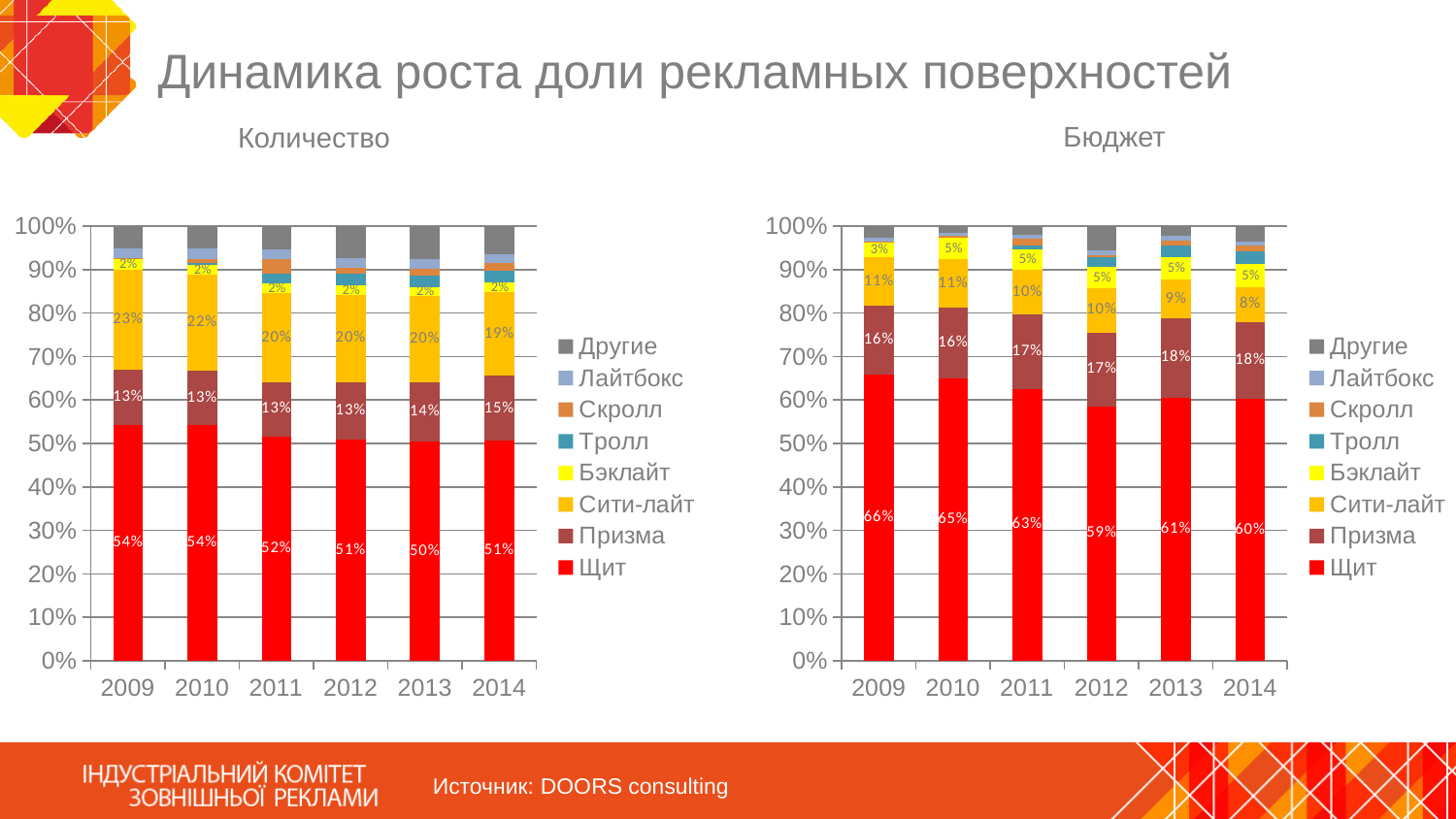
How many series does the legend of the Бюджет chart list? 8 In the Бюджет chart, what is the value for Призма in 2014? 18% In the Бюджет chart, what is the value for Щит in 2012? 59% In the Количество chart, what is the value for Щит in 2009? 54% In the Количество chart, which is larger: the Сити-лайт value in 2009 or in 2012? 2009 What kind of chart is the Бюджет chart? Stacked bar chart In the Бюджет chart, does the Сити-лайт value rise or fall from 2009 to 2014? Fall In the Бюджет chart, what is the difference between the Щит value in 2009 and in 2014? 6% How many years are shown on the x axis of the Количество chart? 6 In the Бюджет chart, which year has the highest value for Щит? 2009 In the Количество chart, what is the value for Сити-лайт in 2014? 19% In the Количество chart, which year has the lowest value for Сити-лайт? 2014